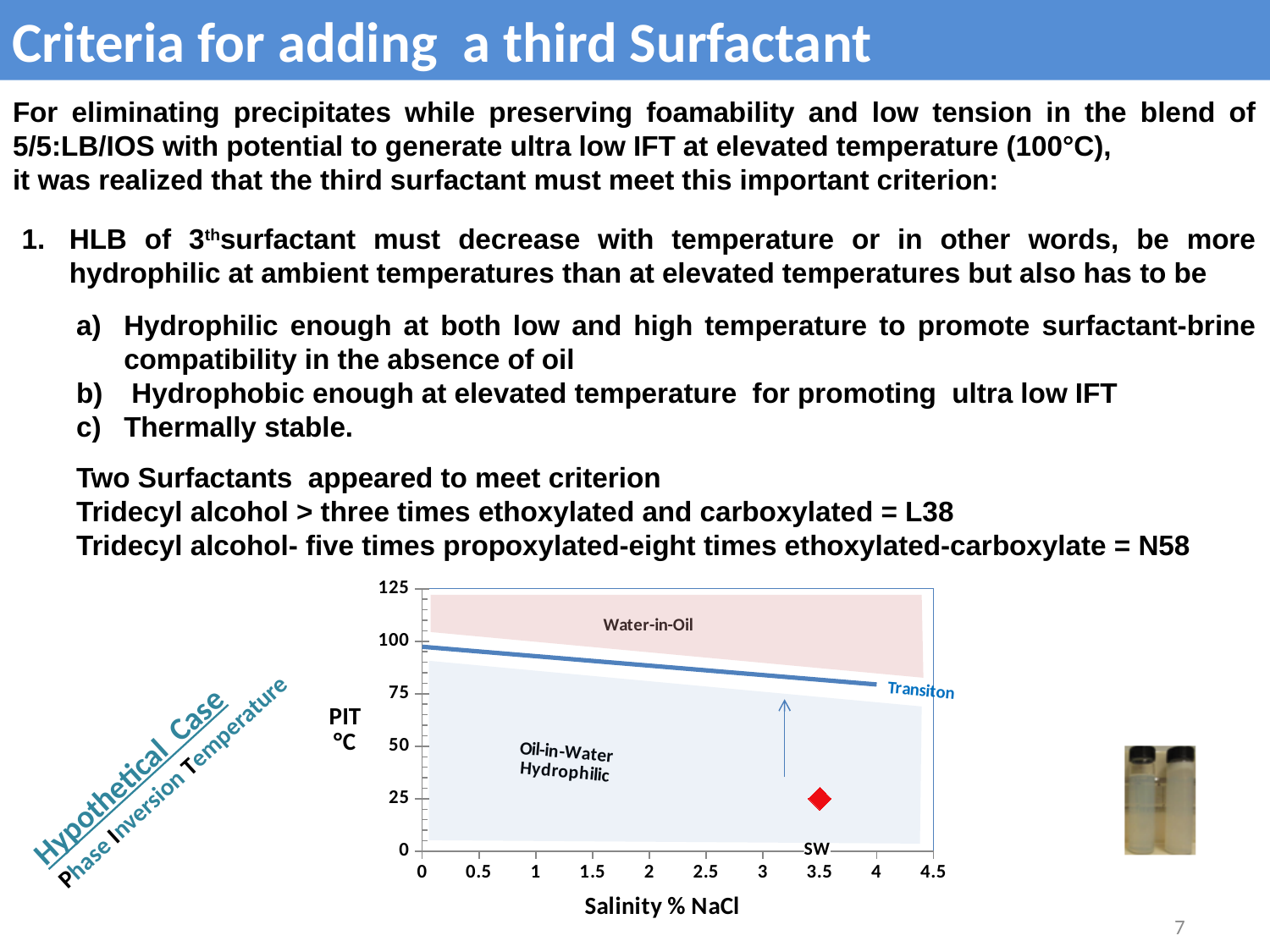
What PIT value (°C) does the red diamond marked SW sit at? 25 What is the label of the x axis of the chart? Salinity % NaCl Which region of the chart lies above the Transition line? Water-in-Oil What is the highest value shown on the y axis of the chart? 125 Is the Transition line value at salinity 4 greater or less than 50? greater Which region of the chart lies below the Transition line? Oil-in-Water Hydrophilic What is the label of the y axis of the chart? PIT °C Does the Transition line rise or fall as salinity increases along the x axis? fall Is the Transition line value at salinity 2 greater or less than 100? less Is the Transition line value at salinity 0 greater or less than 75? greater At what salinity (% NaCl) is the red diamond marked SW plotted? 3.5